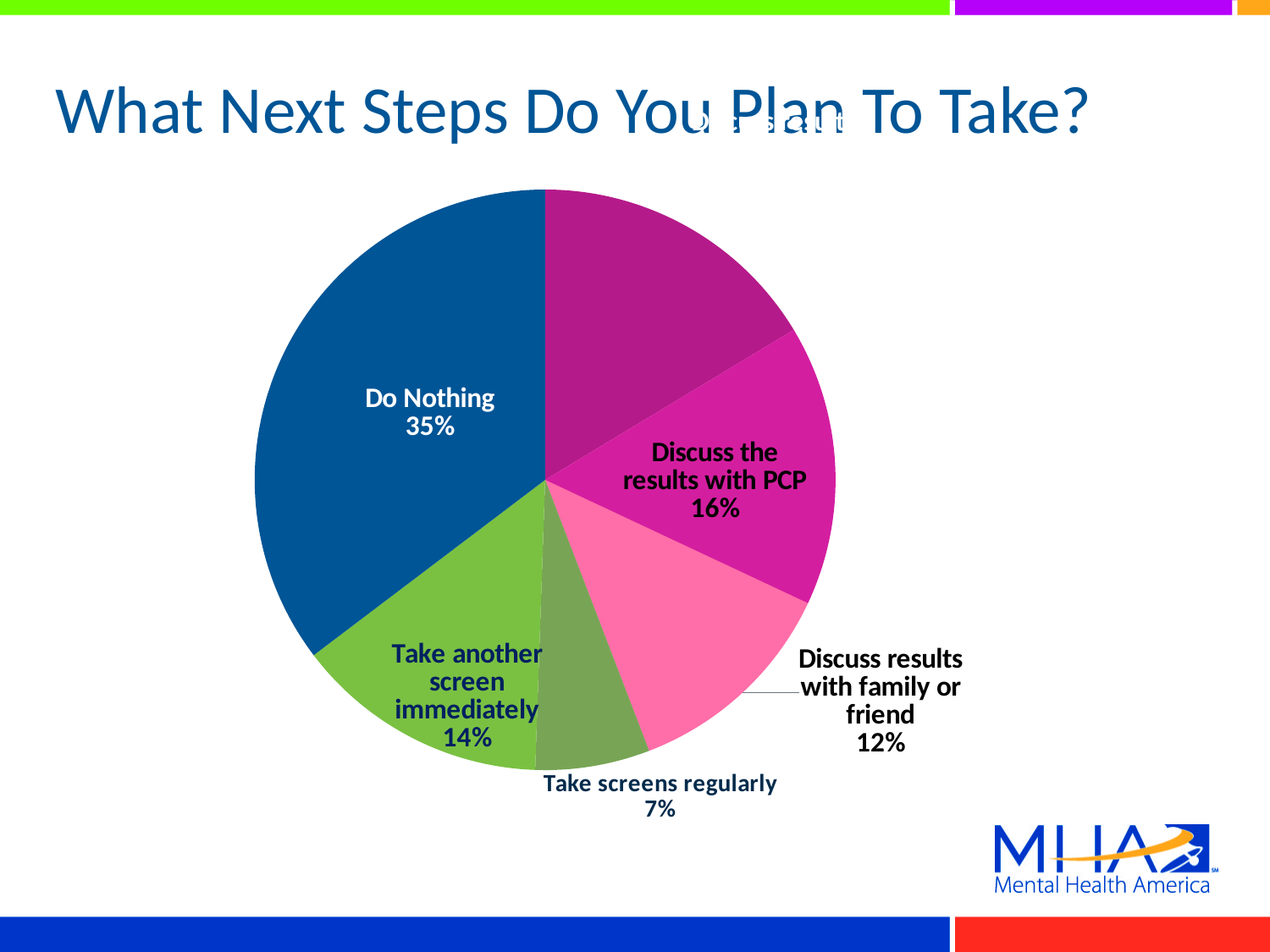
What kind of chart is shown on the slide? pie chart What percentage of respondents plan to take another screen immediately? 14% How many slices does the pie chart have? 6 Which next step has the smallest share of the pie? Take screens regularly What percentage of respondents plan to discuss results with family or friend? 12% What is the title of the chart on the slide? What Next Steps Do You Plan To Take? What percentage of respondents plan to take screens regularly? 7% What percentage of respondents plan to do nothing? 35% How many percentage points larger is the Do Nothing slice than the Discuss the results with PCP slice? 19 What percentage of respondents plan to discuss the results with PCP? 16% Which is larger: the share for Take another screen immediately or the share for Discuss results with family or friend? Take another screen immediately Which next step has the largest share of the pie? Do Nothing